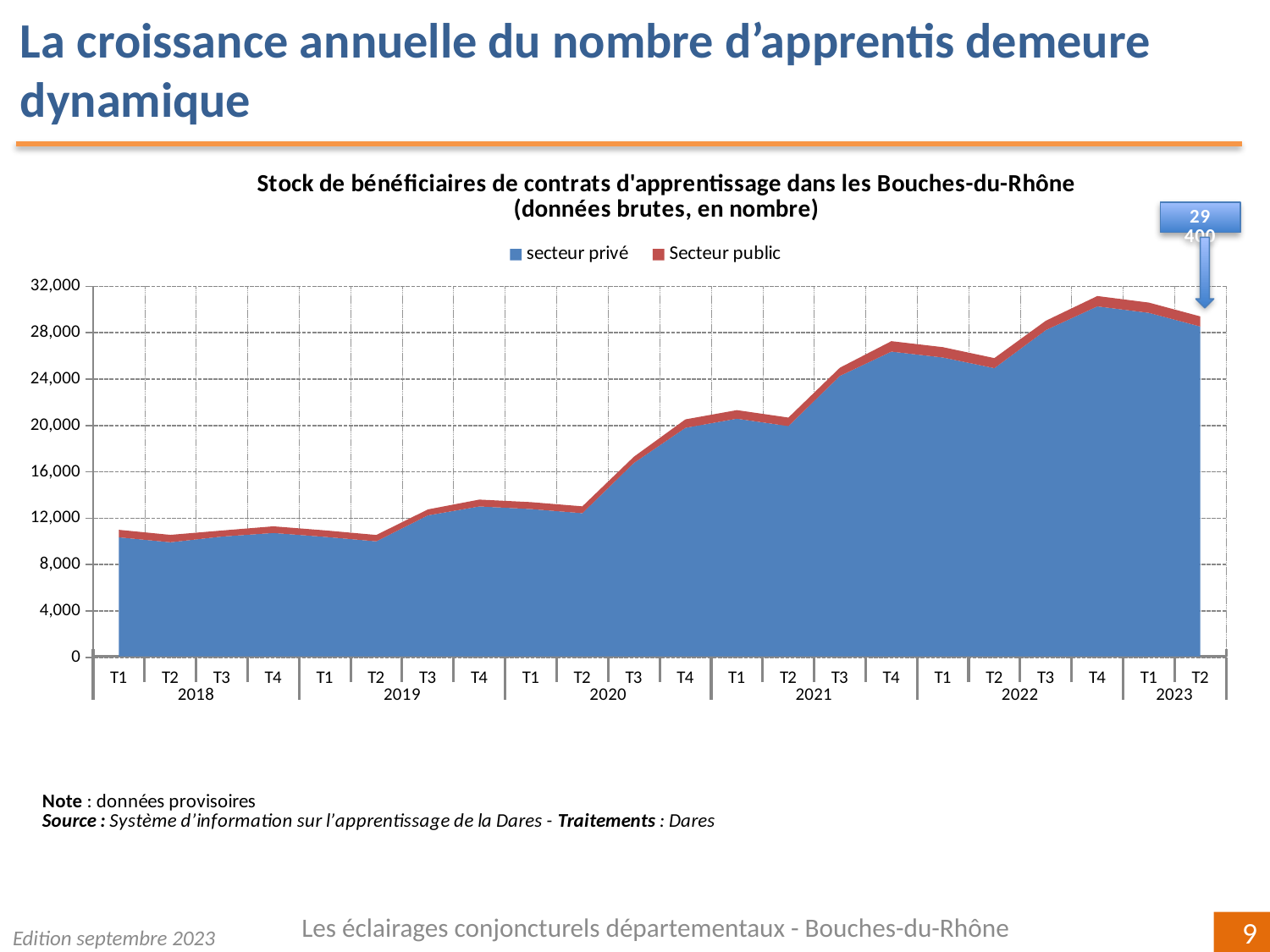
How many quarterly data points are plotted along the x axis? 22 What total value is indicated by the callout for T2 2023? 29 400 What are the two series named in the legend? secteur privé and Secteur public Which series accounts for the larger share of the stacked area, secteur privé or Secteur public? secteur privé What kind of chart is shown on the slide? area chart Which is larger, the total for T4 2022 or the total for T2 2023? T4 2022 Which quarter has the highest total stock of apprenticeship beneficiaries? T4 2022 Is the total value for T2 2020 greater or less than 16,000? less Do the values generally rise or fall from T1 2018 to T2 2023? rise Is the total value for T4 2022 greater or less than 28,000? greater How many series does the legend list? 2 Is the total value for T1 2018 greater or less than 8,000? greater